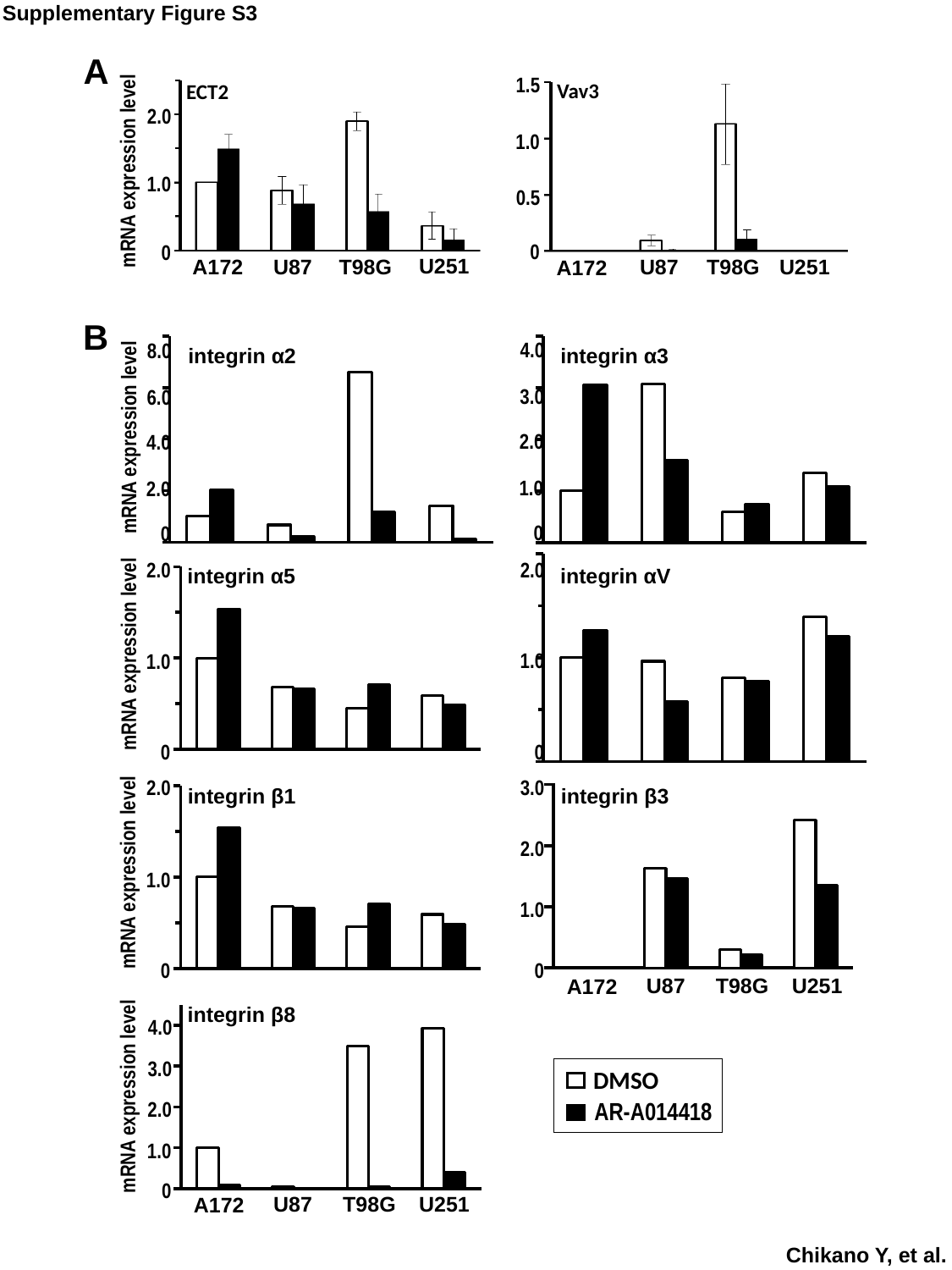
How many series does the legend list? 2 In the integrin β3 chart, which cell line has the lowest DMSO bar? A172 In the integrin α2 chart, is the DMSO value for T98G greater or less than 6.0? greater In the integrin α2 chart, which cell line has the highest DMSO bar? T98G In the Vav3 chart, is the DMSO value for T98G greater or less than 1.0? greater In the integrin β3 chart, which cell line has the highest DMSO bar? U251 In the ECT2 chart, for T98G, which is larger: the DMSO bar or the AR-A014418 bar? DMSO In the integrin β8 chart, is the DMSO value for T98G greater or less than 3.0? greater How many cell lines are shown on the x axis of the ECT2 chart? 4 What kind of chart is the ECT2 chart in panel A? bar chart In the integrin α5 chart, for A172, which is larger: the DMSO bar or the AR-A014418 bar? AR-A014418 What are the two entries in the legend? DMSO and AR-A014418